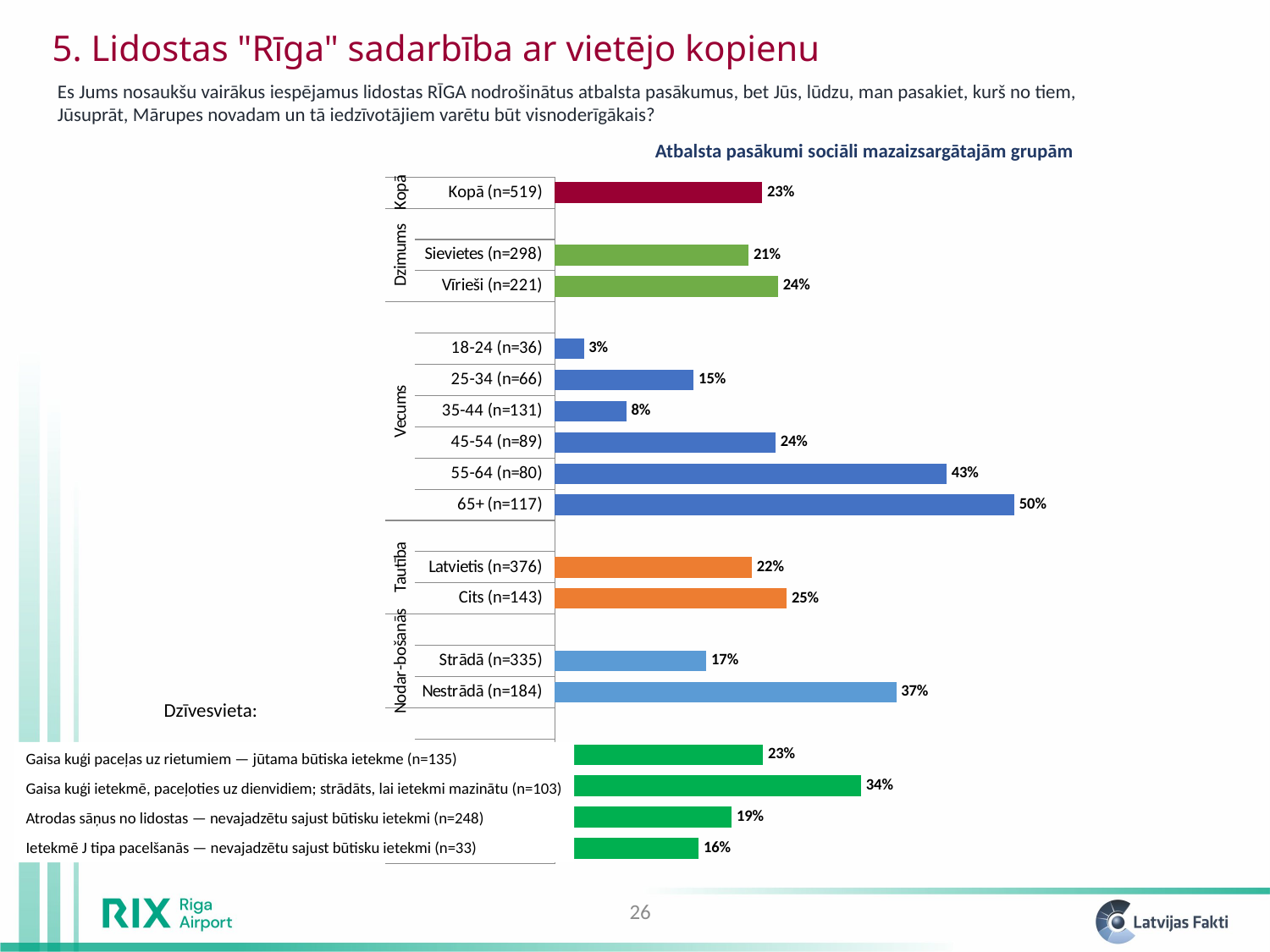
Which is larger, the value for Strādā (n=335) or Nestrādā (n=184)? Nestrādā (n=184) What kind of chart is shown on the slide? Bar chart What is the title of the chart? Atbalsta pasākumi sociāli mazaizsargātajām grupām What is the value for Sievietes (n=298)? 21% Which category has the highest value on the chart? 65+ (n=117) What is the value for Kopā (n=519)? 23% What is the value for 'Gaisa kuģi ietekmē, paceļoties uz dienvidiem; strādāts, lai ietekmi mazinātu (n=103)'? 34% What is the difference between the values for 55-64 (n=80) and 25-34 (n=66)? 28% Which category has the lowest value on the chart? 18-24 (n=36) What is the value for Nestrādā (n=184)? 37% What is the difference between the values for Cits (n=143) and Latvietis (n=376)? 3% What is the value for the 65+ (n=117) age group? 50%